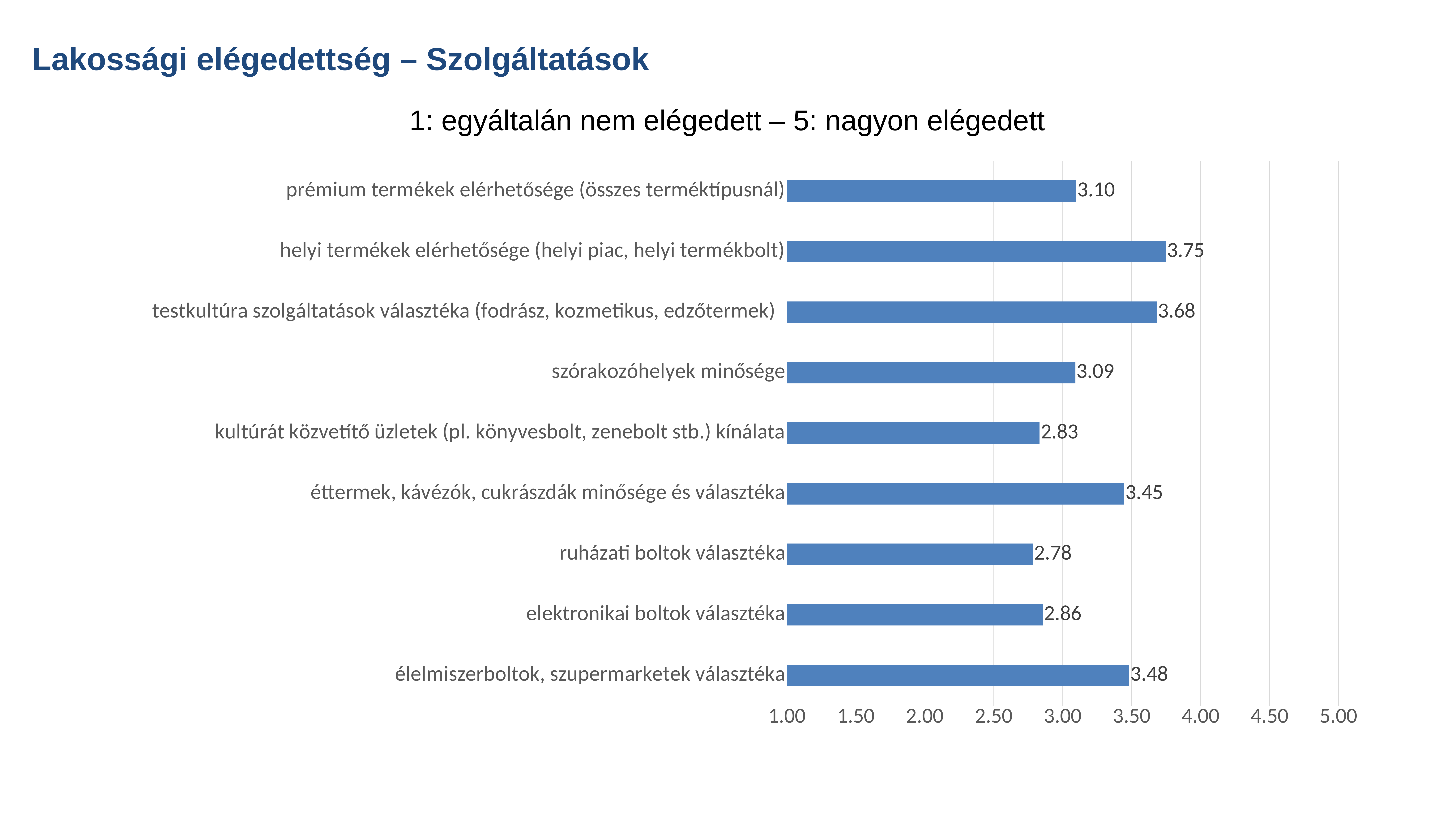
Which category has the highest value? helyi termékek elérhetősége (helyi piac, helyi termékbolt) Which category has the lowest value? ruházati boltok választéka How many categories are shown in the chart? 9 What is the difference between the values for "helyi termékek elérhetősége (helyi piac, helyi termékbolt)" and "prémium termékek elérhetősége (összes terméktípusnál)"? 0.65 What is the value for "szórakozóhelyek minősége"? 3.09 What is the title of the chart? 1: egyáltalán nem elégedett – 5: nagyon elégedett What is the value for "élelmiszerboltok, szupermarketek választéka"? 3.48 Is the value for "kultúrát közvetítő üzletek (pl. könyvesbolt, zenebolt stb.) kínálata" greater or less than 3.00? less Which is larger: the value for "éttermek, kávézók, cukrászdák minősége és választéka" or for "élelmiszerboltok, szupermarketek választéka"? élelmiszerboltok, szupermarketek választéka What kind of chart is shown on the slide? bar chart What is the value for "ruházati boltok választéka"? 2.78 What is the difference between the values for "elektronikai boltok választéka" and "ruházati boltok választéka"? 0.08